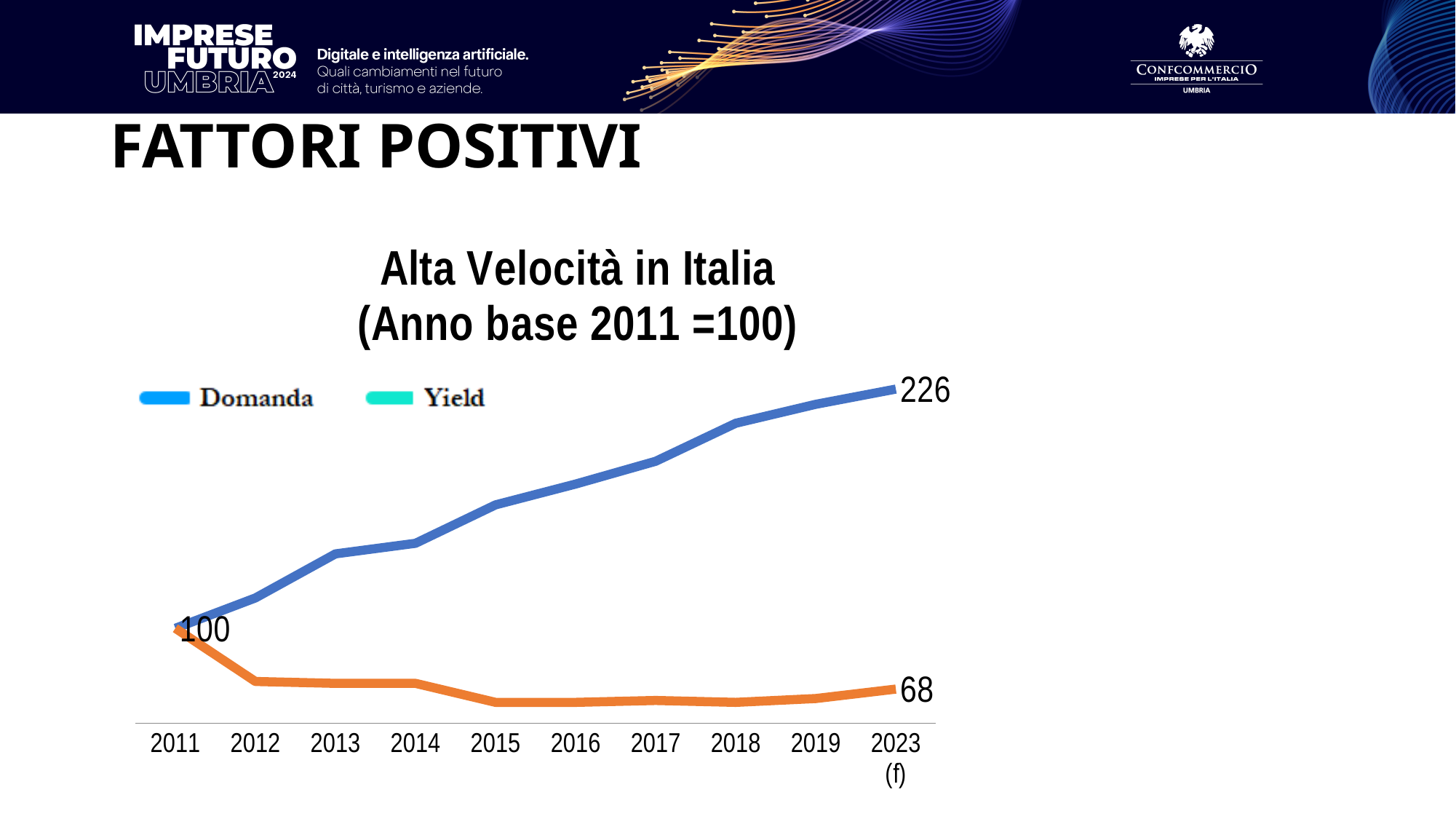
What is the value of both series in the base year 2011? 100 By how much does Domanda increase from 2011 to 2023 (f)? 126 By how much does Yield decrease from 2011 to 2023 (f)? 32 What is the value of Domanda in 2023 (f)? 226 What is the value of Yield in 2023 (f)? 68 Does the Domanda series rise or fall from 2011 to 2023 (f)? rise What kind of chart is shown on the slide? line chart Which series has the higher value in 2023 (f), Domanda or Yield? Domanda What is the title of the chart? Alta Velocità in Italia (Anno base 2011 =100) How many years are shown on the x axis? 10 What is the difference between Domanda and Yield in 2023 (f)? 158 How many series does the legend list? 2